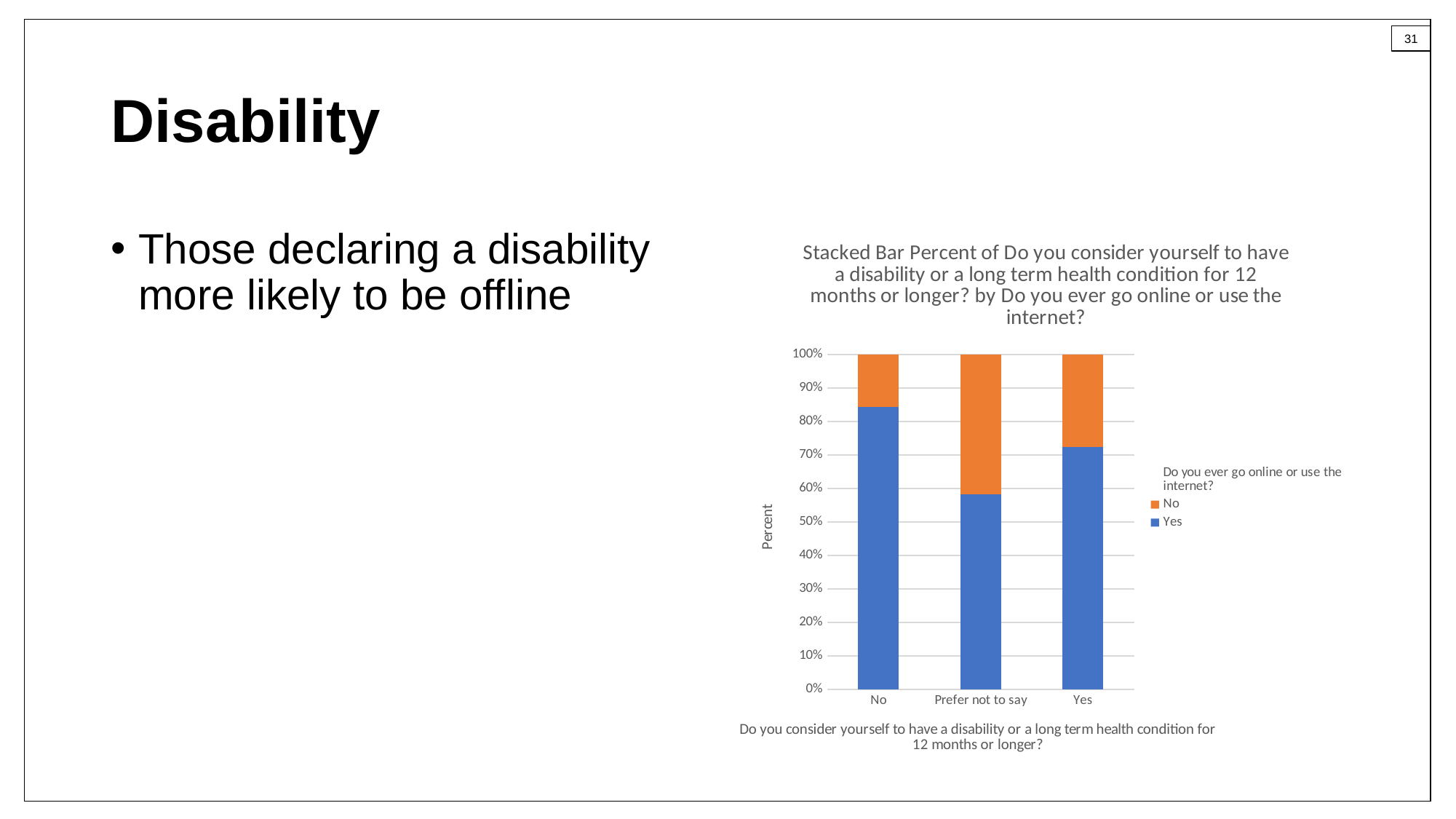
Is the 'Yes' (go online) share for the 'No' disability category greater or less than 80%? greater Which is larger: the 'Yes' (go online) share for the 'No' disability category or for the 'Yes' disability category? No How many series does the chart's legend list? 2 Is the 'Yes' (go online) share for the 'Yes' disability category greater or less than 80%? less What kind of chart is shown on the slide? Stacked bar chart Which category has the smallest 'Yes' (go online) share? Prefer not to say Which category has the largest 'No' (do not go online) share? Prefer not to say What is the label on the vertical axis of the chart? Percent What is the total height of each stacked bar in the chart? 100% Which category has the largest 'Yes' (go online) share? No How many categories are shown on the x axis of the chart? 3